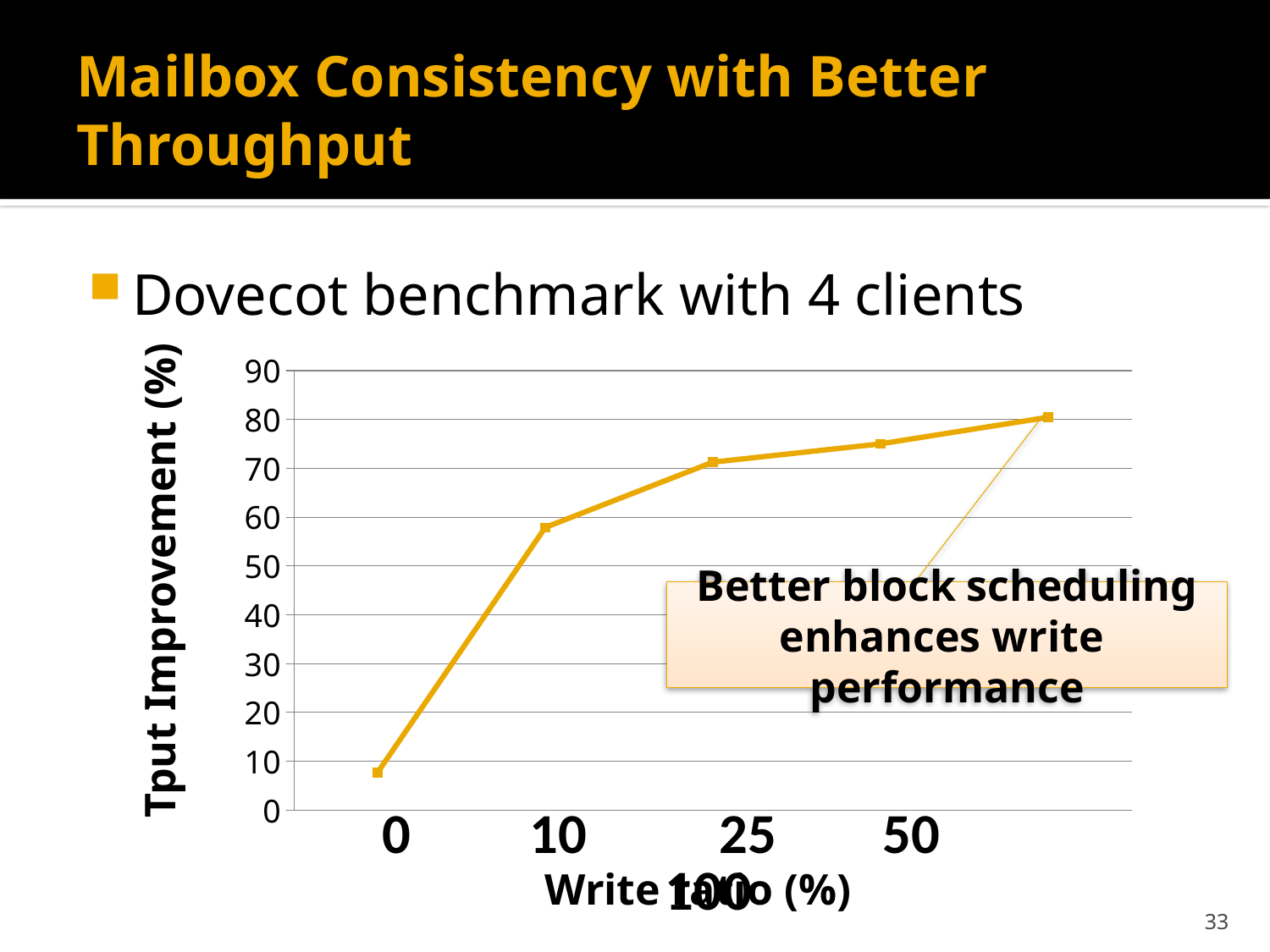
What kind of chart is shown on the slide? line chart Which has the larger throughput improvement, a write ratio of 10 or a write ratio of 25? 25 Which write ratio has the lowest throughput improvement? 0 How many data points are plotted on the line? 5 Which write ratio has the highest throughput improvement? 100 Is the throughput improvement at a write ratio of 100 greater or less than 70? greater What is the label of the y axis? Tput Improvement (%) Does the throughput improvement rise or fall as the write ratio increases along the x axis? rise Is the throughput improvement at a write ratio of 0 greater or less than 10? less Is the throughput improvement at a write ratio of 10 greater or less than 50? greater What does the callout box on the chart say? Better block scheduling enhances write performance